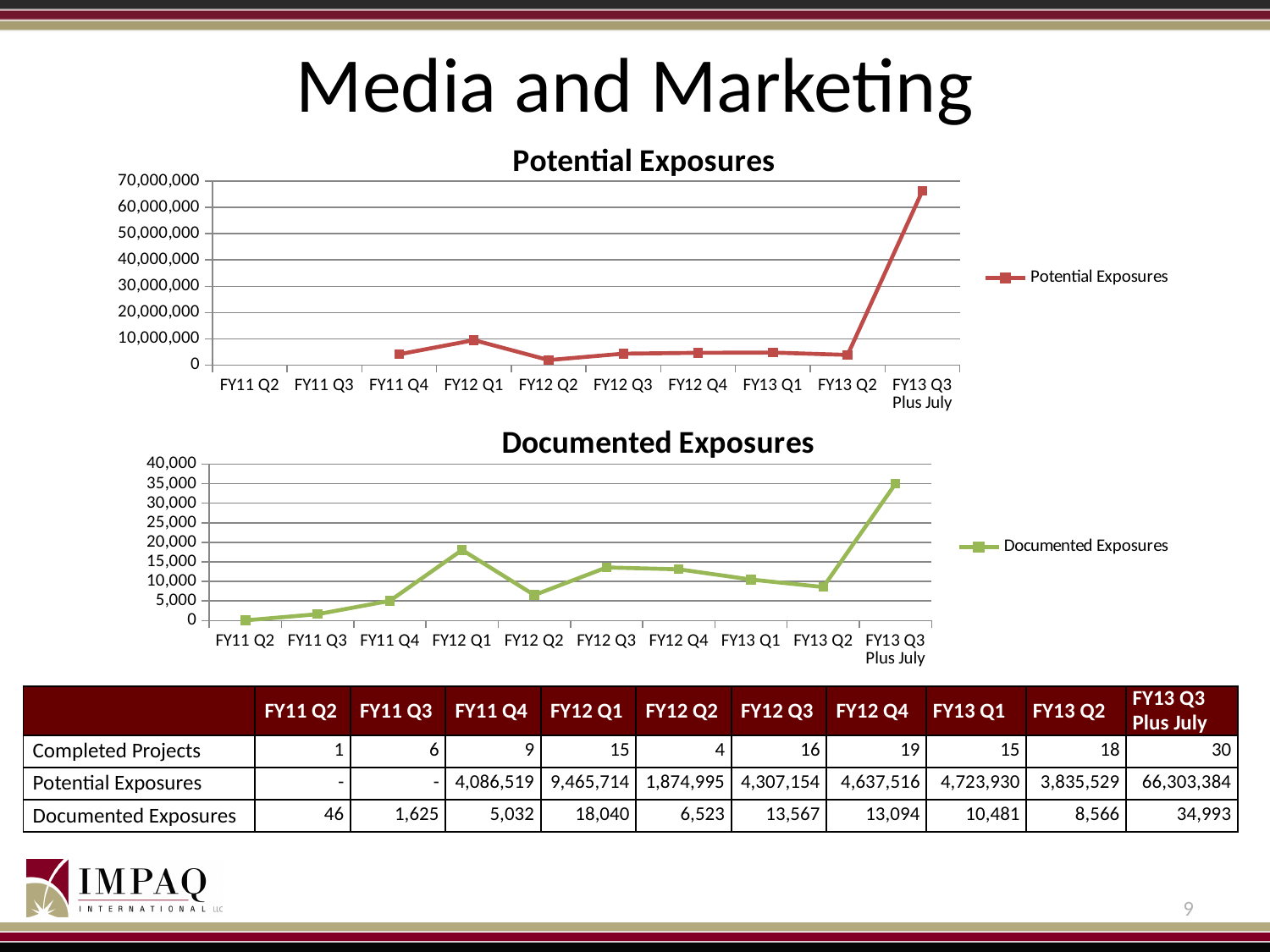
In the Potential Exposures chart, which period has the highest value? FY13 Q3 Plus July In the Potential Exposures chart, which is larger, FY12 Q1 or FY12 Q2? FY12 Q1 How many series does the legend of the Potential Exposures chart list? 1 How many periods are shown on the x axis of the Documented Exposures chart? 10 In the Documented Exposures chart, which period has the lowest value? FY11 Q2 In the Documented Exposures chart, do the values rise or fall from FY12 Q3 to FY13 Q2? fall In the Potential Exposures chart, is the value for FY13 Q3 Plus July greater or less than 60,000,000? greater What is the title of the lower chart on the slide? Documented Exposures In the Documented Exposures chart, what is the difference between FY13 Q3 Plus July and FY13 Q2? 26,427 What kind of chart is the Potential Exposures chart? line chart In the Potential Exposures chart, what is the value for FY12 Q3? 4,307,154 In the Documented Exposures chart, what is the value for FY12 Q1? 18,040